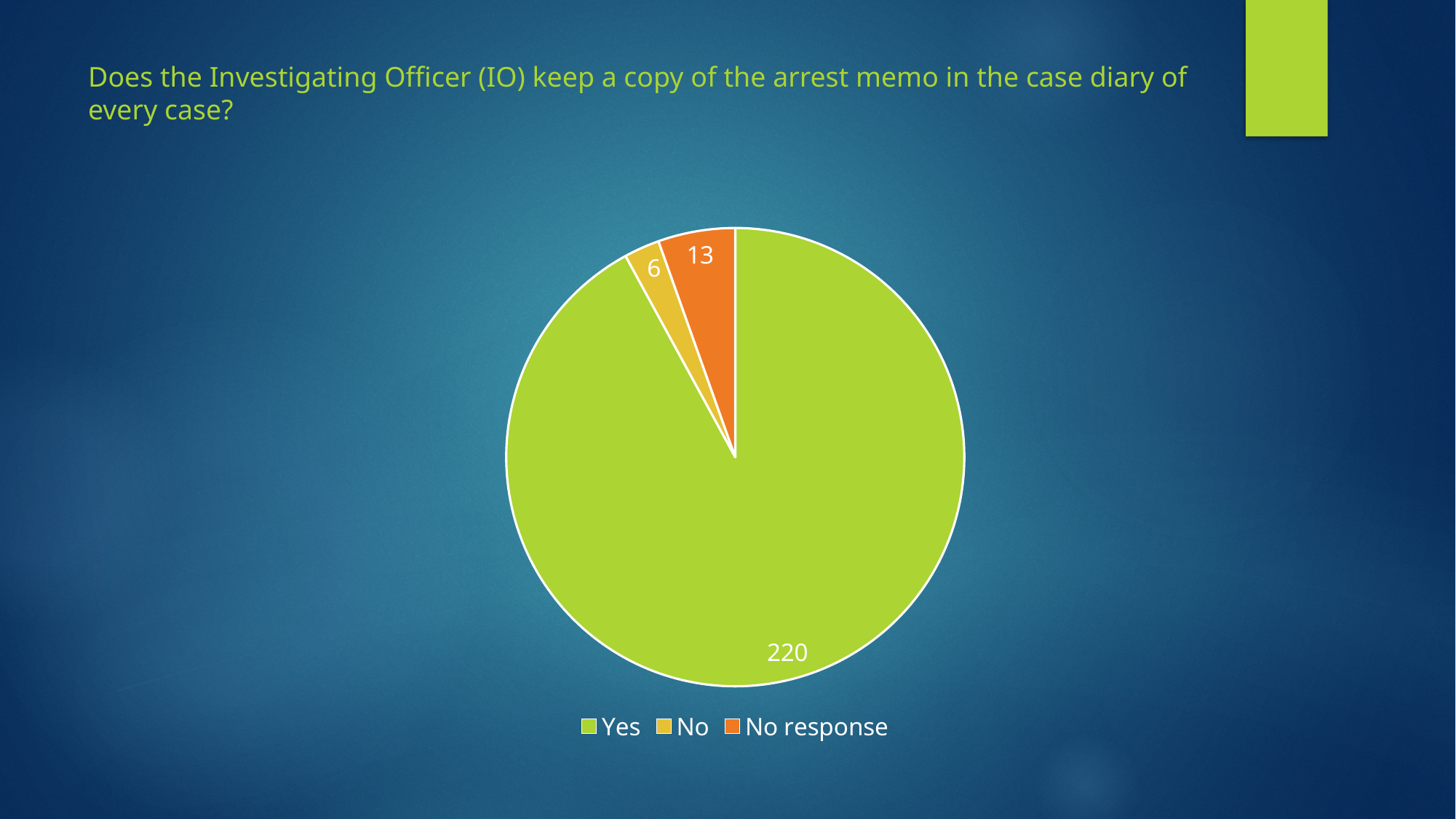
What kind of chart is shown on the slide? pie chart How many categories does the pie chart have? 3 How many responses are recorded for "Yes"? 220 How many responses are recorded for "No"? 6 What share of the total does the "Yes" slice represent, to the nearest whole percent? 92% Which is larger, the value for "No" or the value for "No response"? No response Which category has the largest slice of the pie? Yes What is the total of all the values shown in the pie chart? 239 Which category has the smallest slice of the pie? No What is the difference between the "No response" and "No" values? 7 How many responses are recorded for "No response"? 13 What is the difference between the "Yes" and "No response" values? 207